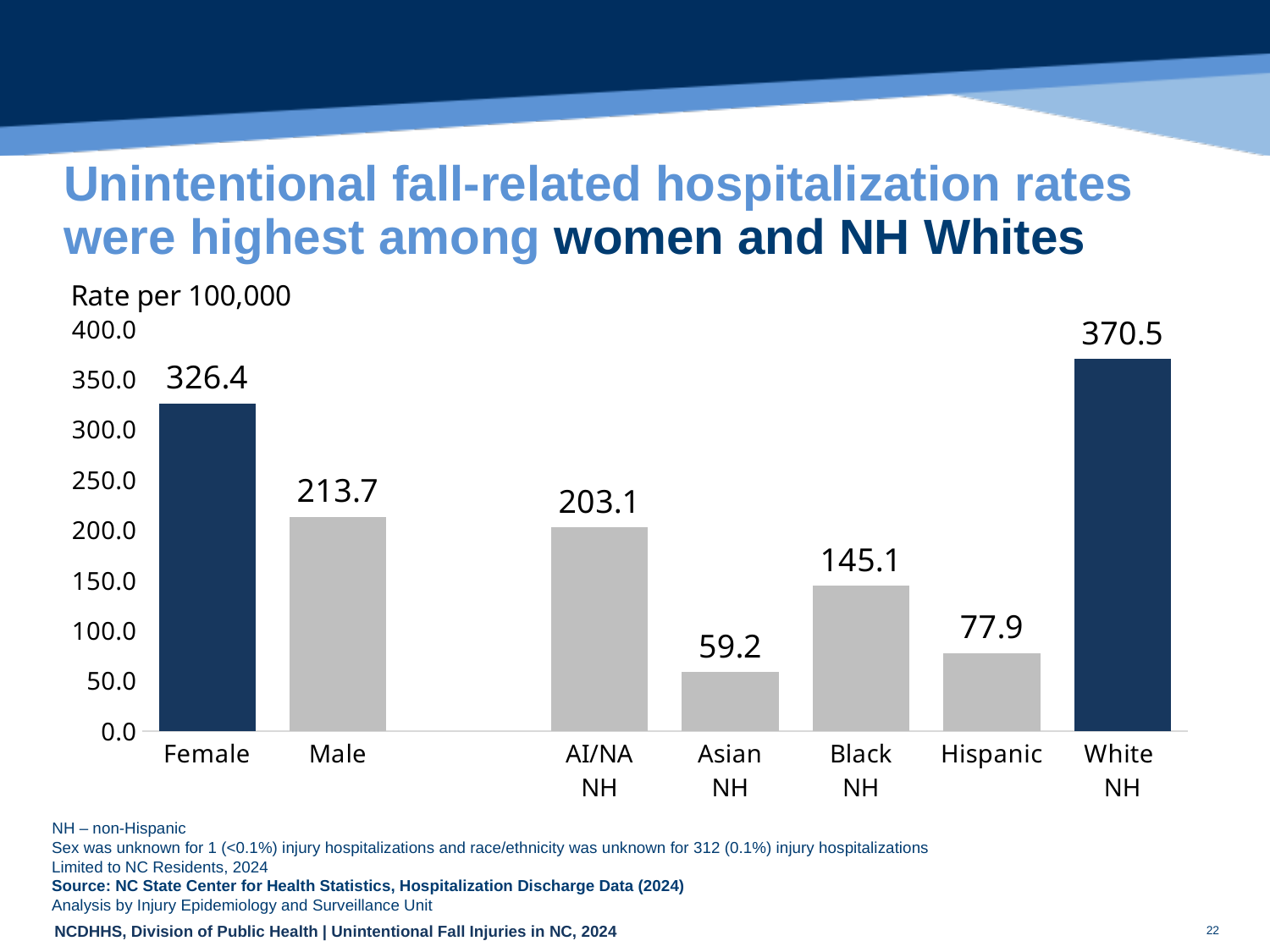
What is the rate per 100,000 for Asian NH? 59.2 How many categories are shown on the chart? 7 Is the value for Male greater or less than 200.0? greater What kind of chart is shown on the slide? Bar chart What is the difference between the White NH and Black NH rates? 225.4 What is the rate per 100,000 for Hispanic? 77.9 What is the unintentional fall-related hospitalization rate per 100,000 for Female? 326.4 What is the difference between the Female and Male rates? 112.7 Which category has the lowest rate on the chart? Asian NH What unit is the chart's y axis labelled with? Rate per 100,000 Which has a higher rate, AI/NA NH or Black NH? AI/NA NH Which category has the highest rate on the chart? White NH